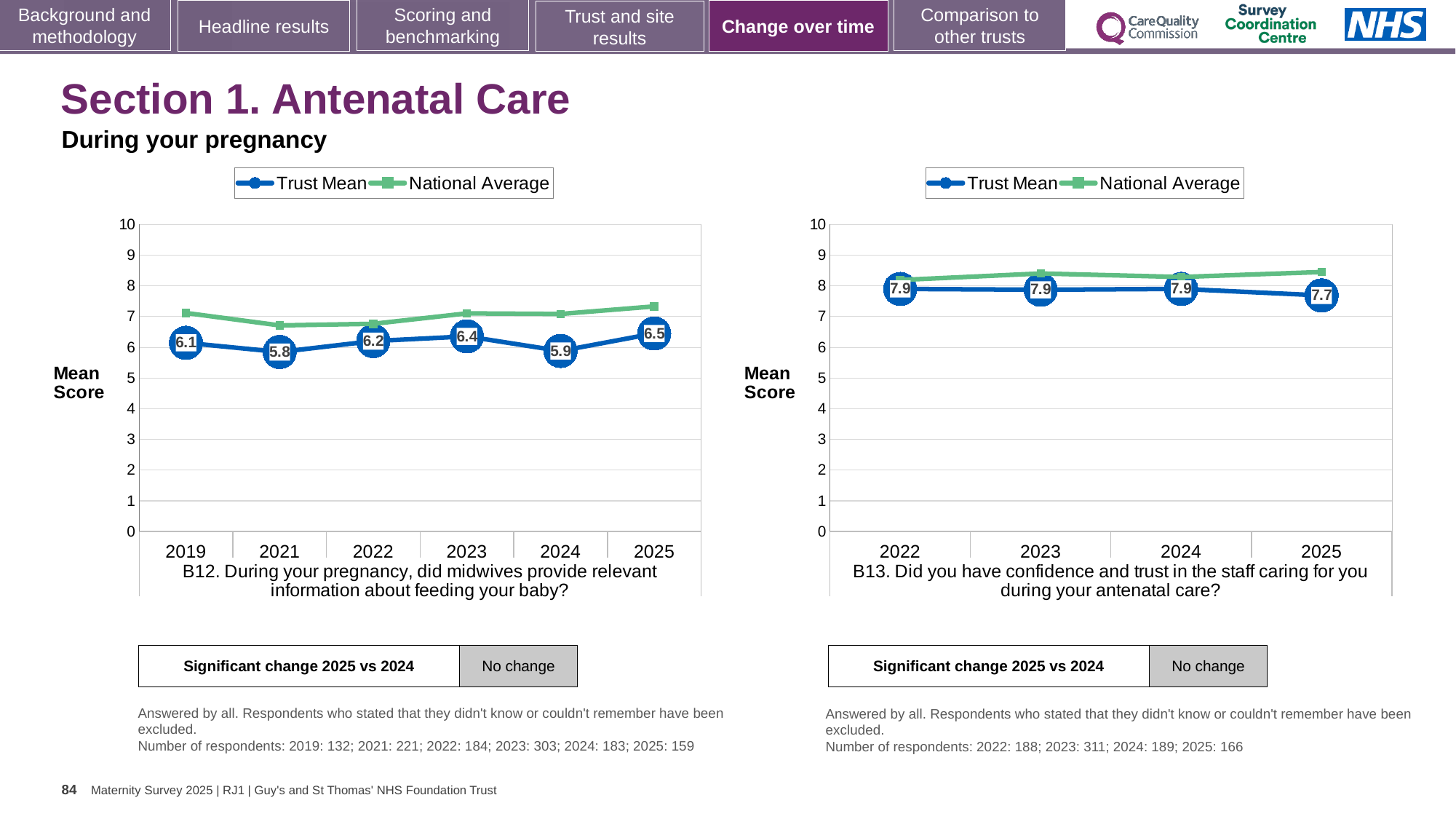
In the B12 chart (left), which year has the highest Trust Mean? 2025 In the B12 chart (left), what is the Trust Mean for 2021? 5.8 In the B12 chart (left), what is the Trust Mean for 2025? 6.5 In the B12 chart (left), how many years are shown on the x axis? 6 In the B12 chart (left), is the National Average for 2025 greater or less than 7? greater In the B13 chart (right), what is the Trust Mean for 2025? 7.7 What kind of chart is the B13 chart (right)? Line chart In the B12 chart (left), what is the difference between the Trust Mean for 2025 and the Trust Mean for 2024? 0.6 In the B12 chart (left), which year has the lowest Trust Mean? 2021 In the B13 chart (right), what is the label on the y axis? Mean Score In the B13 chart (right), which is larger in 2025, the Trust Mean or the National Average? National Average In the B13 chart (right), how many series does the legend list? 2